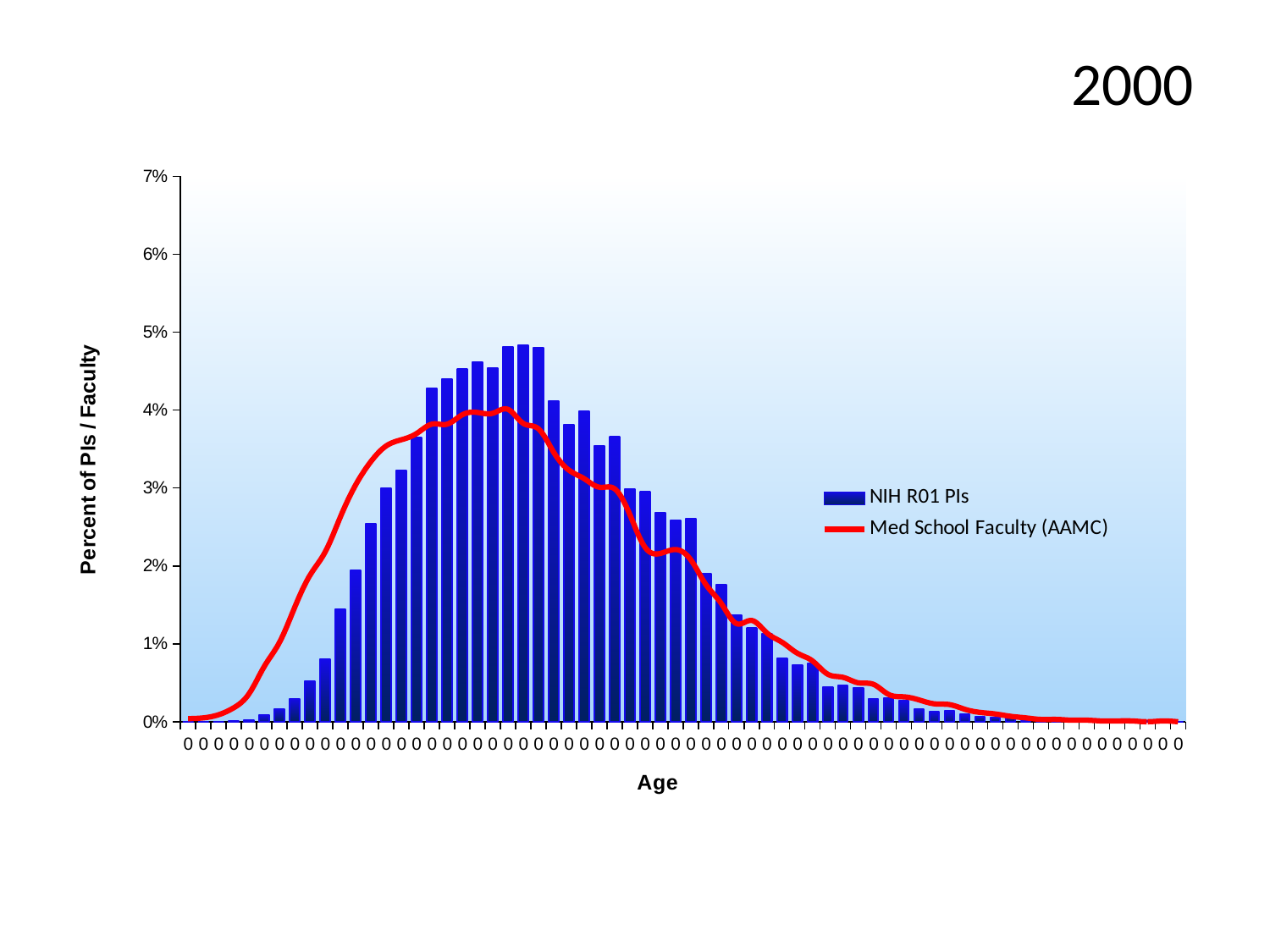
What kind of chart is used for the NIH R01 PIs series? bar chart Is the highest value of the NIH R01 PIs bars greater or less than 4%? greater Which series is drawn as a red line? Med School Faculty (AAMC) Is the highest value of the Med School Faculty (AAMC) line greater or less than 5%? less What is the title of the x axis? Age How many series does the legend list? 2 Which series reaches a higher peak value, NIH R01 PIs or Med School Faculty (AAMC)? NIH R01 PIs